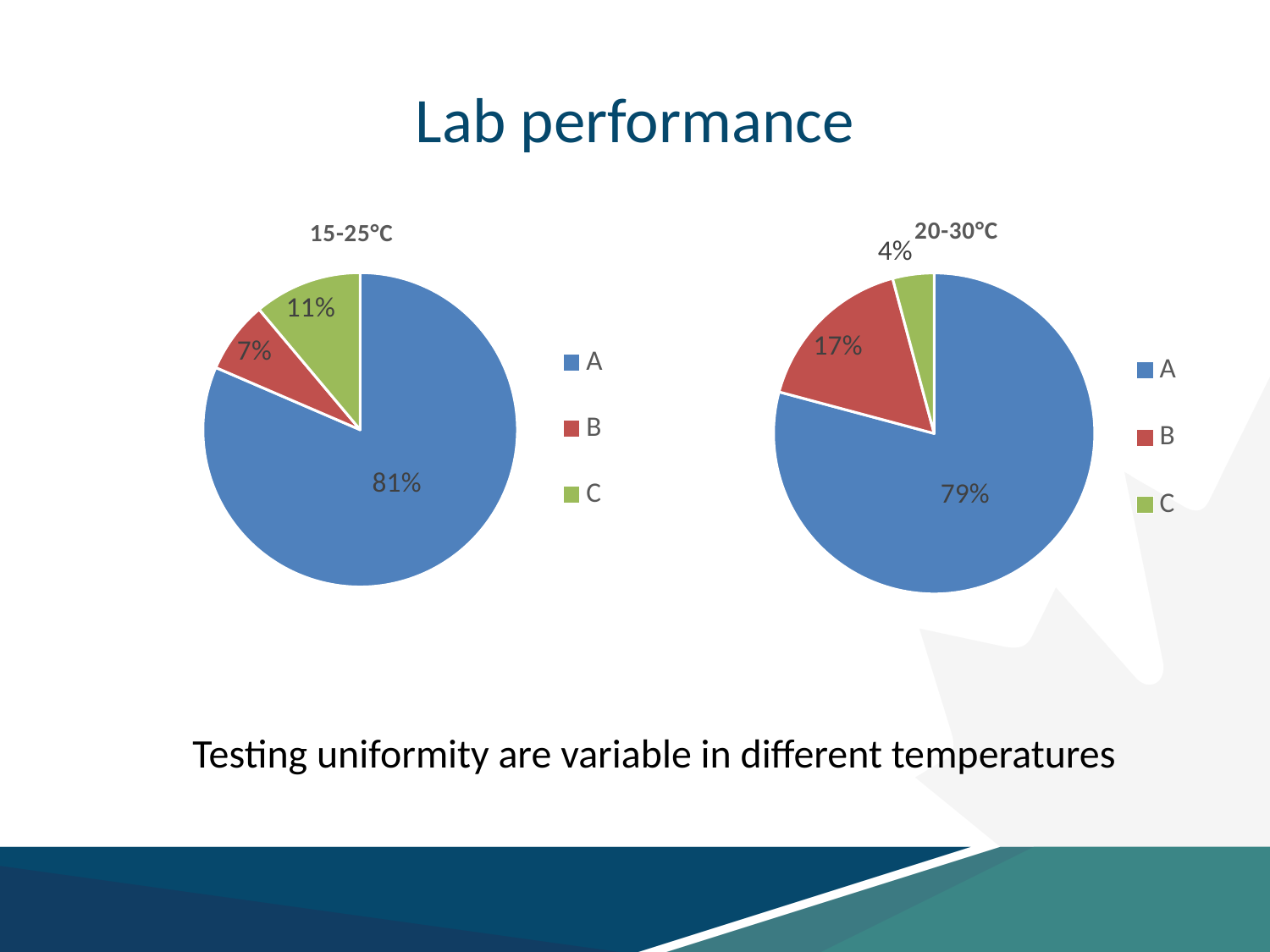
In the 20-30°C chart, what is the difference in percentage points between slices B and C? 13 In the 15-25°C chart, which category has the smallest slice? B In the 15-25°C chart, what share does slice A have? 81% In the 20-30°C chart, which category has the largest slice? A In the 20-30°C chart, what share does slice A have? 79% In the 20-30°C chart, what share does slice C have? 4% In the 15-25°C chart, what share does slice B have? 7% In the 15-25°C chart, what share does slice C have? 11% In the 20-30°C chart, what share does slice B have? 17% In the 15-25°C chart, which slice is larger, B or C? C How many categories does the legend of the 20-30°C chart list? 3 What kind of chart is the 15-25°C chart? pie chart